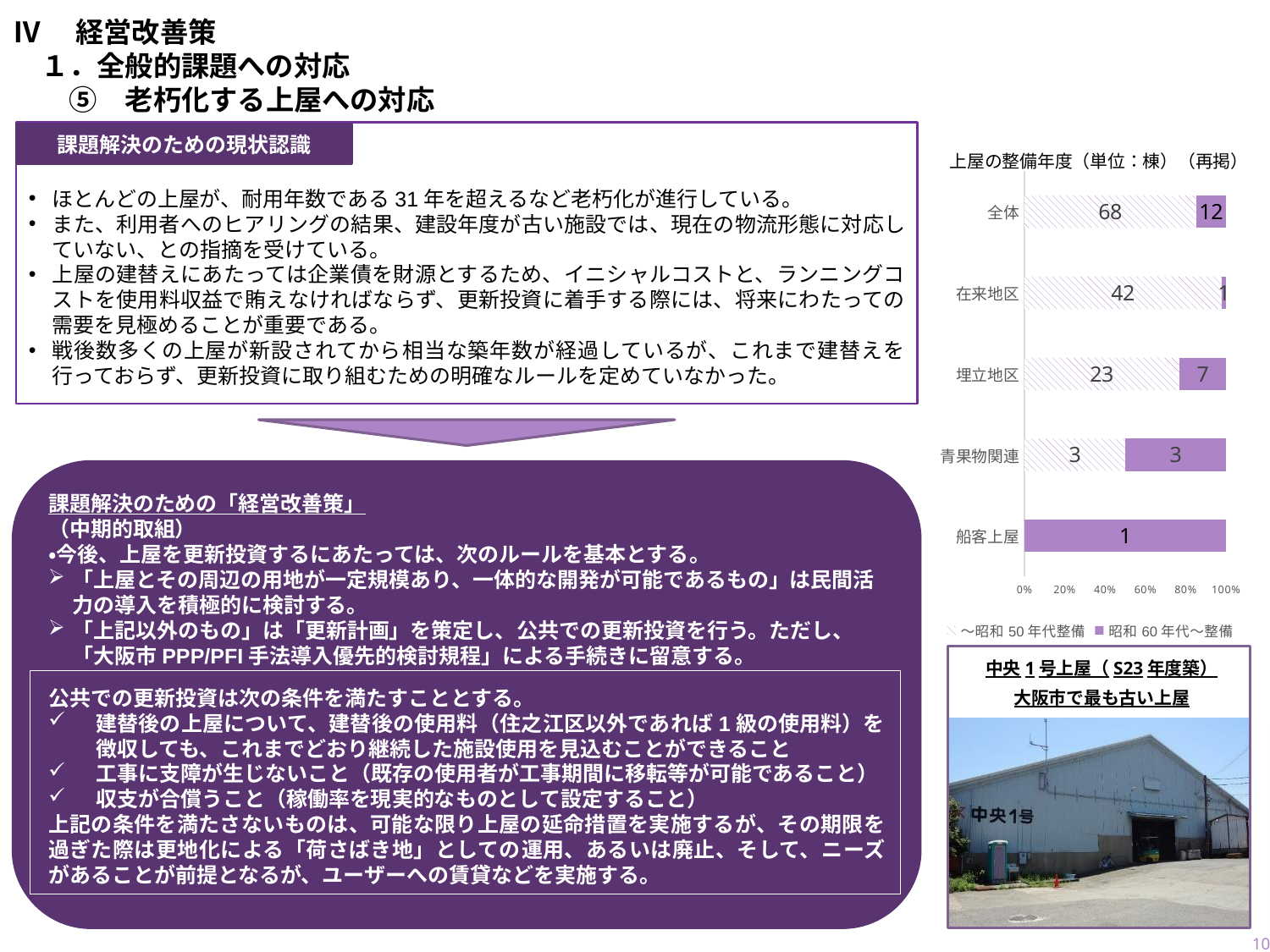
What is the value for 全体 in the ～昭和50年代整備 series? 68 Which is larger for 埋立地区: the ～昭和50年代整備 value or the 昭和60年代～整備 value? ～昭和50年代整備 Which category has the highest value in the ～昭和50年代整備 series? 全体 What is the title of the chart on the right side of the slide? 上屋の整備年度（単位：棟）（再掲） What is the value for 埋立地区 in the 昭和60年代～整備 series? 7 What is the total number of 棟 for 埋立地区 across both series? 30 What is the difference between the ～昭和50年代整備 and 昭和60年代～整備 values for 在来地区? 41 How many series does the chart's legend list? 2 How many categories are shown on the chart's vertical axis? 5 What kind of chart is shown on the right side of the slide? bar chart What is the value for 在来地区 in the ～昭和50年代整備 series? 42 What is the value for 全体 in the 昭和60年代～整備 series? 12